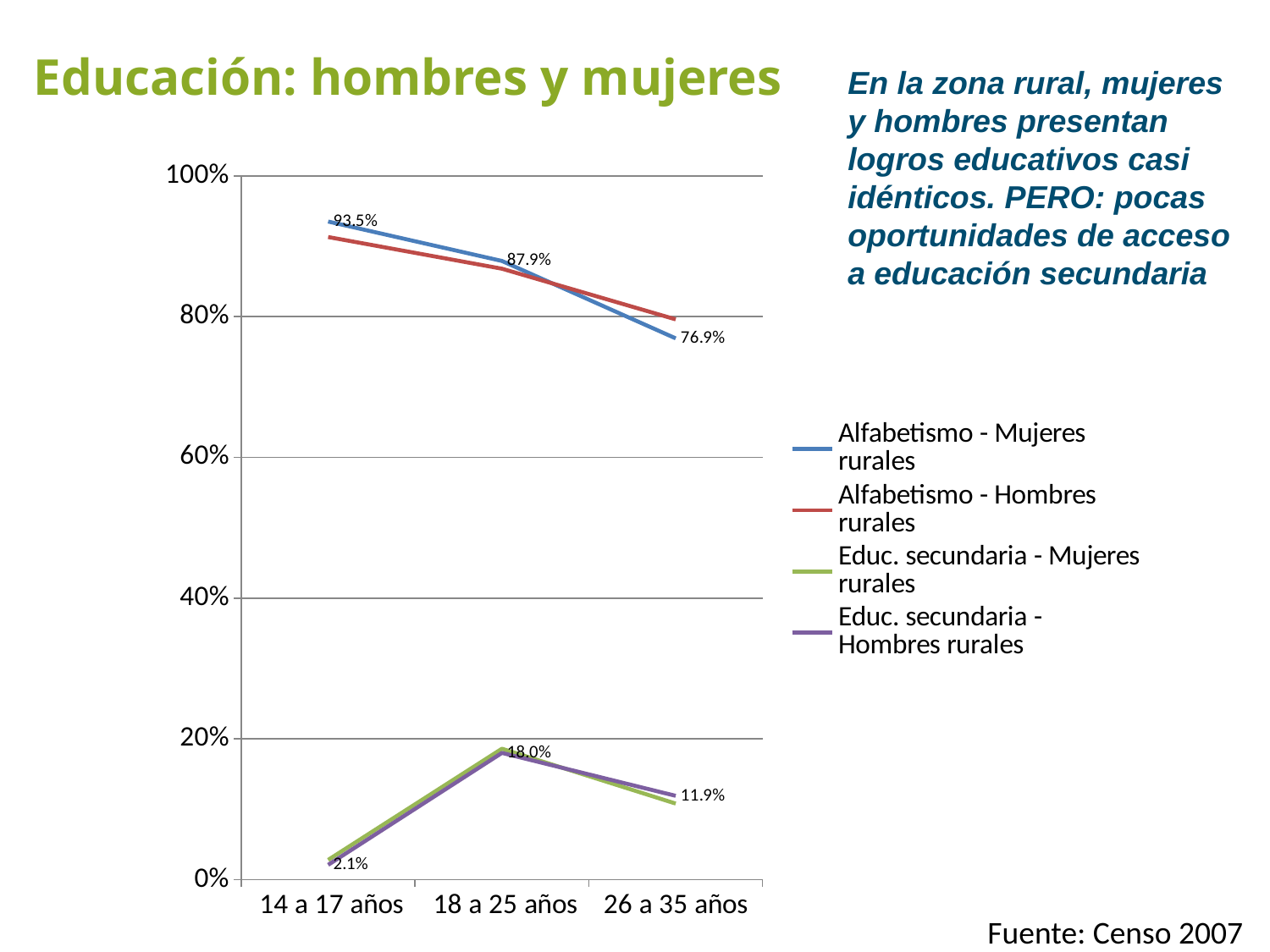
What kind of chart is shown on the slide? Line chart In which age group is Educ. secundaria - Mujeres rurales lowest? 14 a 17 años What is the value for Alfabetismo - Mujeres rurales in the 26 a 35 años group? 76.9% How many age groups are shown on the x axis? 3 How many series does the legend list? 4 What is the value for Alfabetismo - Mujeres rurales in the 14 a 17 años group? 93.5% Is the value for Alfabetismo - Hombres rurales in the 26 a 35 años group greater or less than 60%? greater Does the Alfabetismo - Mujeres rurales line rise or fall from 14 a 17 años to 26 a 35 años? Falls By how many percentage points does Alfabetismo - Mujeres rurales fall from the 14 a 17 años group to the 26 a 35 años group? 16.6 percentage points